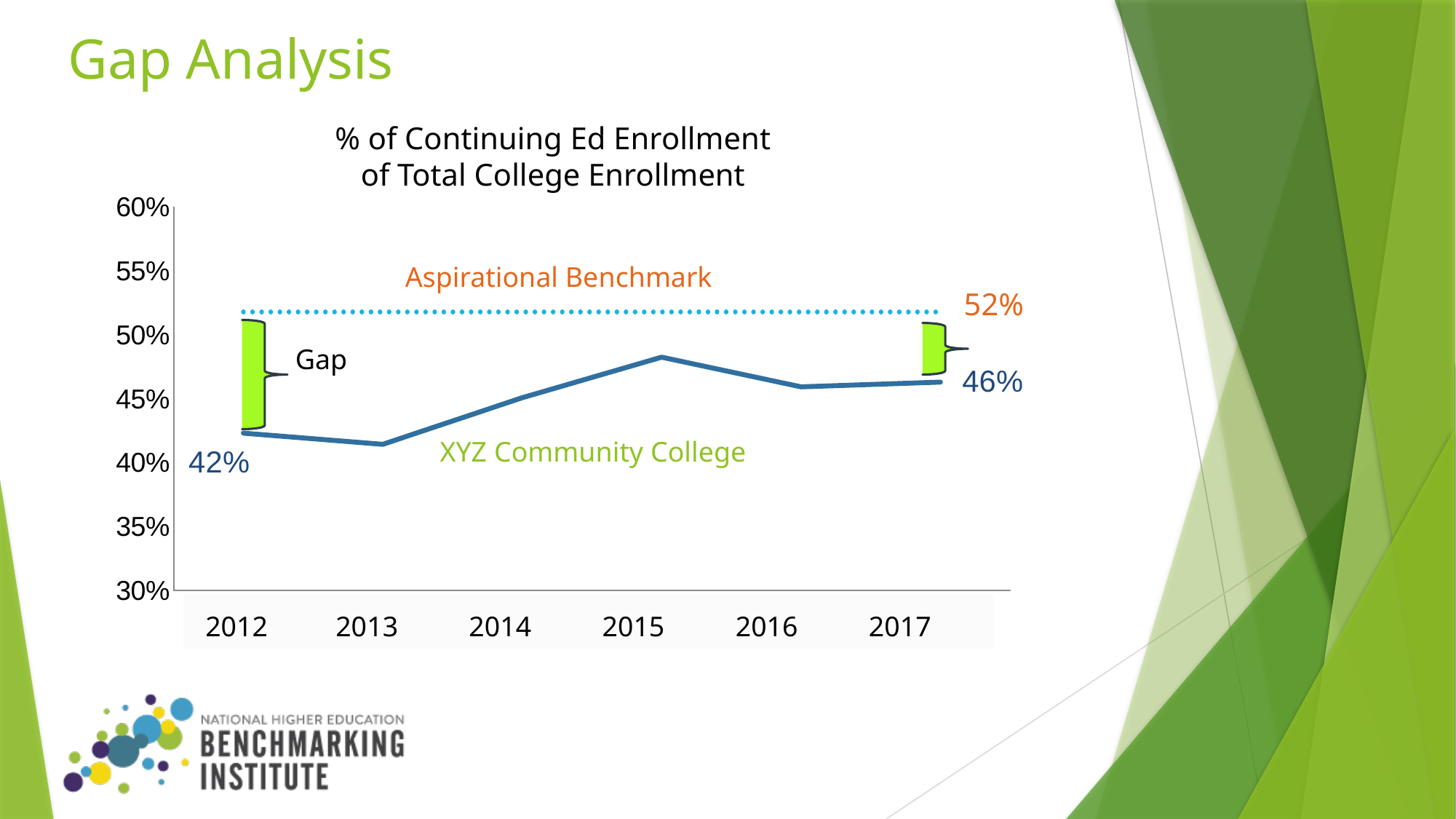
How far below the Aspirational Benchmark is XYZ Community College in 2017? 6 percentage points What is the title of the chart? % of Continuing Ed Enrollment of Total College Enrollment What is the value for XYZ Community College in 2017? 46% Is the value for XYZ Community College in 2015 greater or less than 45%? greater By how much did XYZ Community College's value change from 2012 to 2017? 4 percentage points In which year does the XYZ Community College line reach its highest point? 2015 Overall, does the XYZ Community College line rise or fall from 2012 to 2017? Rises How many years are shown on the x axis? 6 What is the value for XYZ Community College in 2012? 42% What kind of chart is shown on the slide? Line chart Is the value for XYZ Community College in 2013 greater or less than 45%? less What value is the Aspirational Benchmark set at? 52%